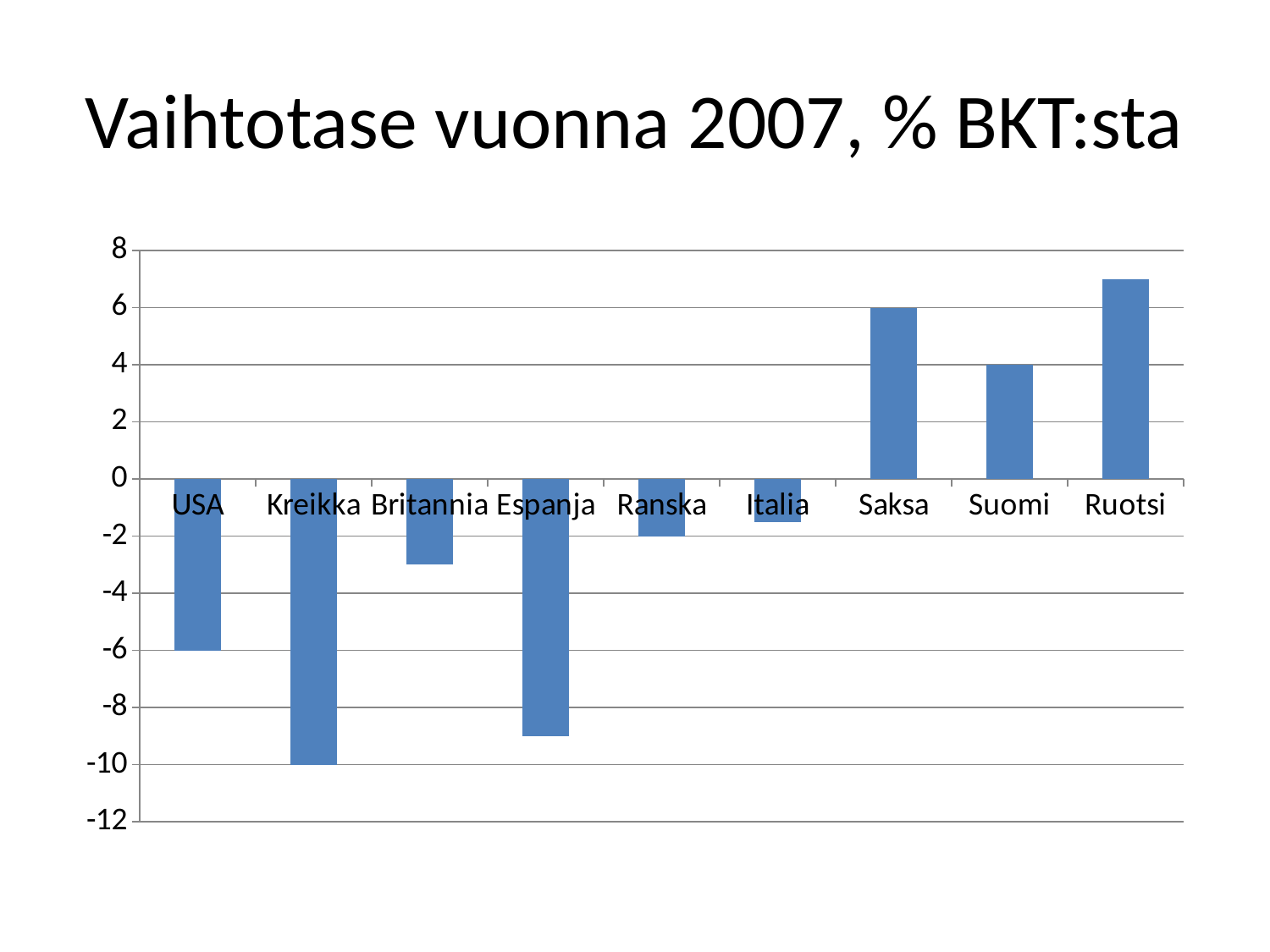
What is the value for USA? -6 Which country has the highest value? Ruotsi What kind of chart is shown on the slide? bar chart What is the value for Saksa? 6 What is the difference between the values for Saksa and Suomi? 2 Is the value for Britannia greater or less than -2? less What is the value for Suomi? 4 How many countries are shown on the chart? 9 What is the value for Kreikka? -10 Which is larger, the value for Saksa or the value for Suomi? Saksa Is the value for Ruotsi greater or less than 6? greater Which country has the lowest value? Kreikka